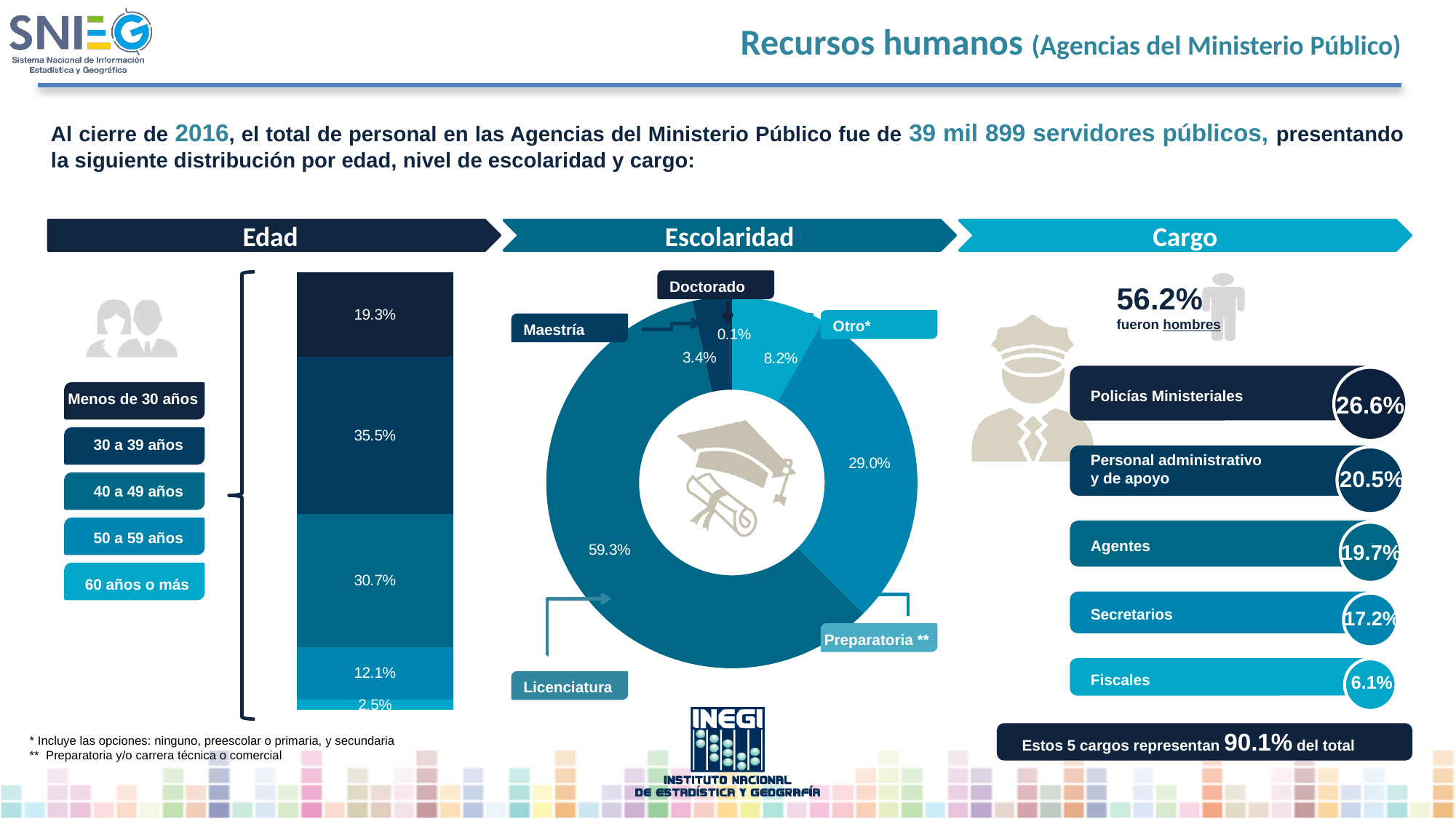
In the Edad stacked bar chart, what is the largest segment value? 35.5% In the Escolaridad donut chart, which category has the smallest share? Doctorado In the Cargo chart, which position has the lowest percentage? Fiscales In the Cargo chart, what is the difference between Agentes and Secretarios? 2.5% What kind of chart is used in the Escolaridad section? Donut (pie) chart In the Escolaridad donut chart, what share corresponds to Preparatoria **? 29.0% In the Cargo chart, which is larger: Personal administrativo y de apoyo or Agentes? Personal administrativo y de apoyo In the Cargo chart, what percentage corresponds to Policías Ministeriales? 26.6% In the Escolaridad donut chart, what is the difference between the Maestría and Doctorado shares? 3.3% In the Escolaridad donut chart, what share corresponds to Licenciatura? 59.3% In the Escolaridad donut chart, which category has the largest share? Licenciatura How many categories does the Escolaridad donut chart show? 5